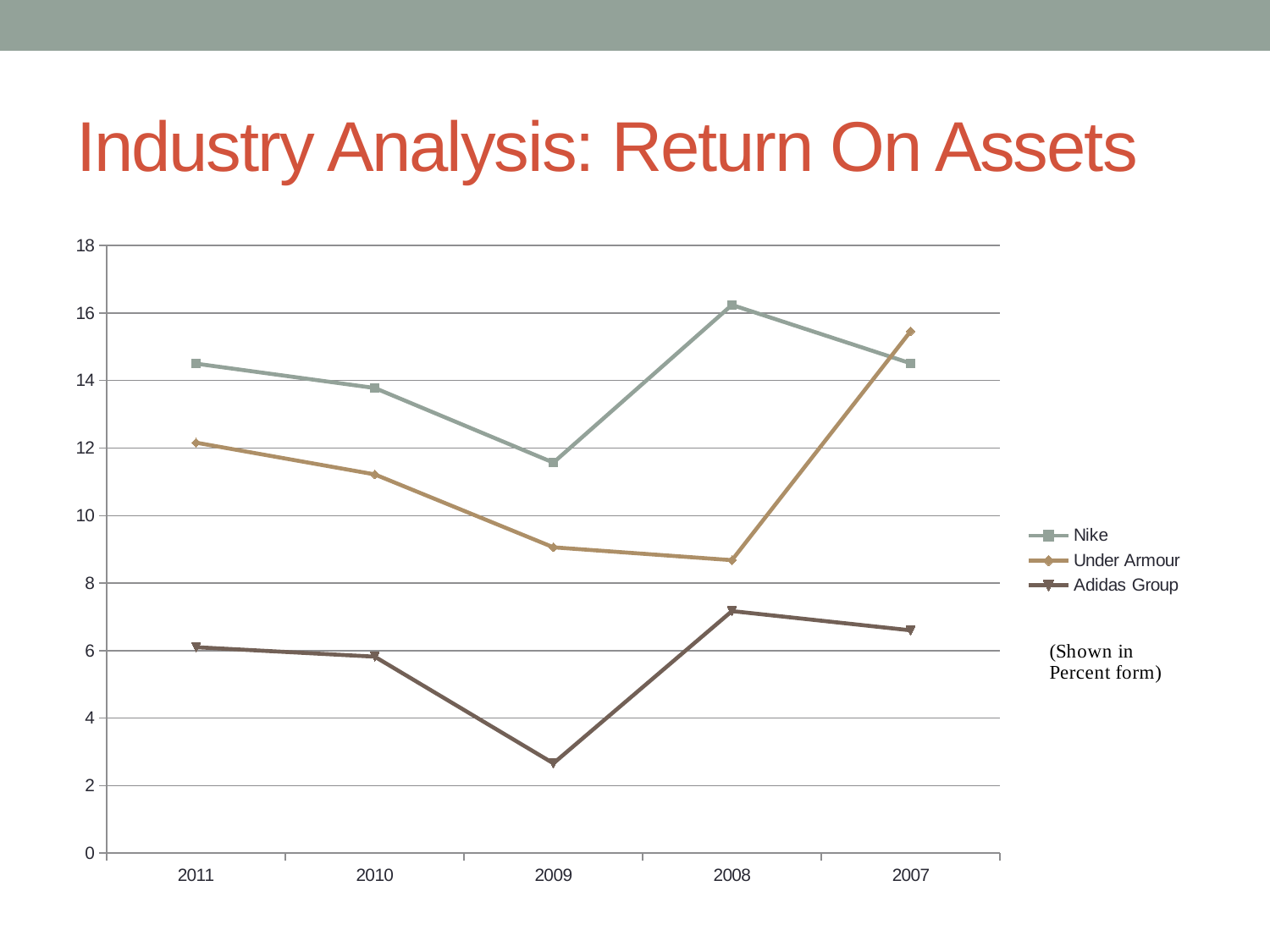
What kind of chart is shown on the slide? line chart In 2007, which is larger: the value for Under Armour or the value for Nike? Under Armour How many years are shown on the x axis? 5 How many series does the legend list? 3 In which year is the Nike value highest? 2008 Does the Adidas Group line rise or fall from 2011 to 2009? fall According to the note beside the legend, in what form are the values shown? Percent form In which year is the Adidas Group value lowest? 2009 In 2011, which is larger: the value for Nike or the value for Under Armour? Nike Is the value for Under Armour in 2007 greater or less than 14? greater Is the value for Nike in 2009 greater or less than 12? less Is the value for Adidas Group in 2009 greater or less than 4? less